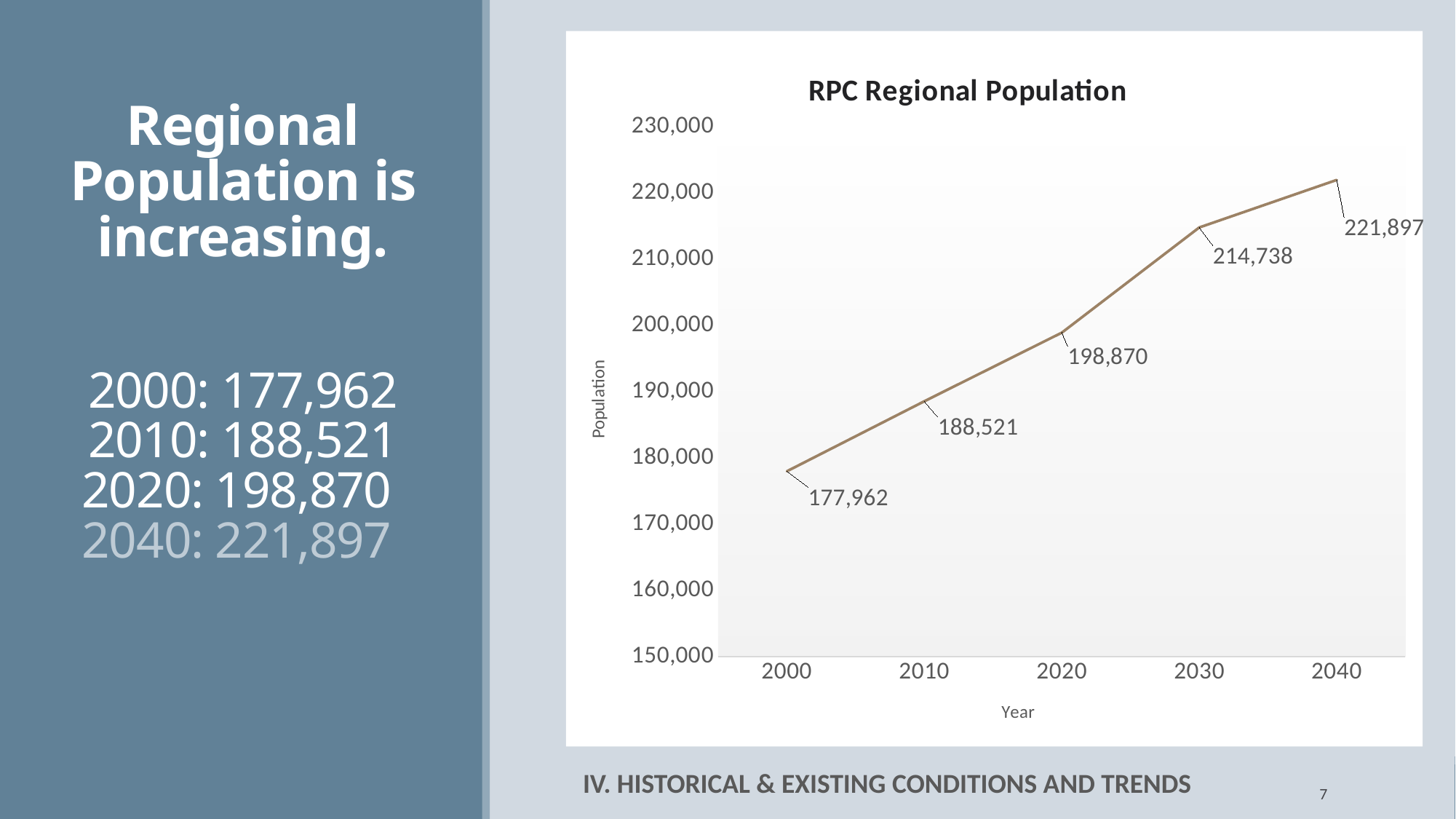
Which is larger, the population in 2010 or the population in 2030? 2030 What is the RPC regional population in 2040? 221,897 What is the RPC regional population in 2000? 177,962 Does the RPC regional population rise or fall from 2000 to 2040? rise What is the difference between the population in 2040 and the population in 2000? 43,935 What is the difference between the population in 2020 and the population in 2010? 10,349 What kind of chart is shown on the slide? line chart Which year has the highest RPC regional population? 2040 How many years are plotted on the chart? 5 Is the population in 2020 greater or less than 200,000? less What is the RPC regional population in 2030? 214,738 Which year has the lowest RPC regional population? 2000